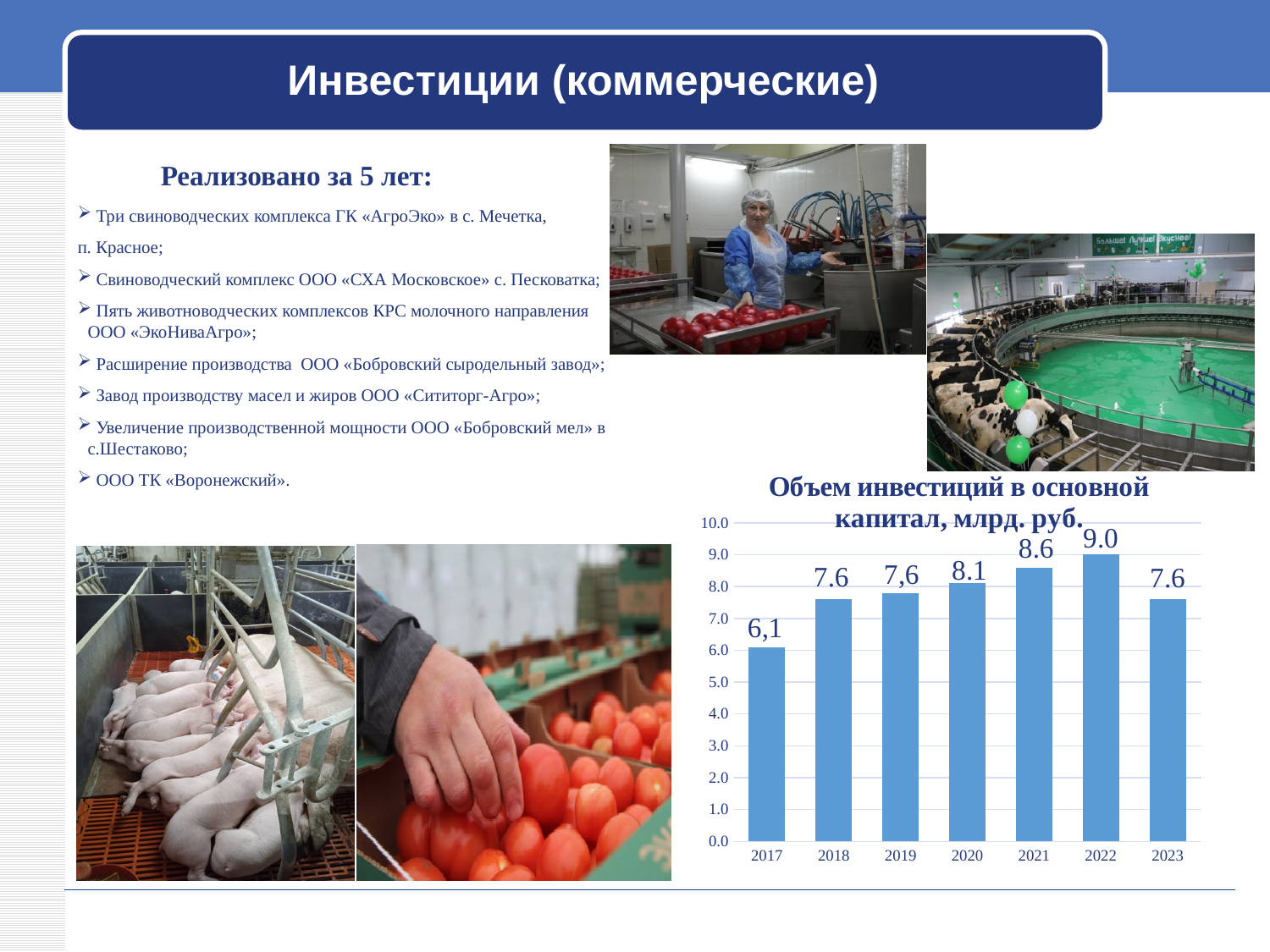
What is the value for 2020 in the chart? 8.1 Which year has the lowest value in the chart? 2017 What is the title of the chart on the slide? Объем инвестиций в основной капитал, млрд. руб. How many years are shown on the x axis of the chart? 7 What is the value for 2022 in the chart? 9.0 Which is larger, the value for 2020 or the value for 2021? 2021 Do the values rise or fall from 2017 to 2022? rise What is the value for 2017 in the chart? 6,1 What is the difference between the values for 2022 and 2017? 2.9 What type of chart is shown on the slide? bar chart What is the value for 2023 in the chart? 7.6 Which year has the highest value in the chart? 2022